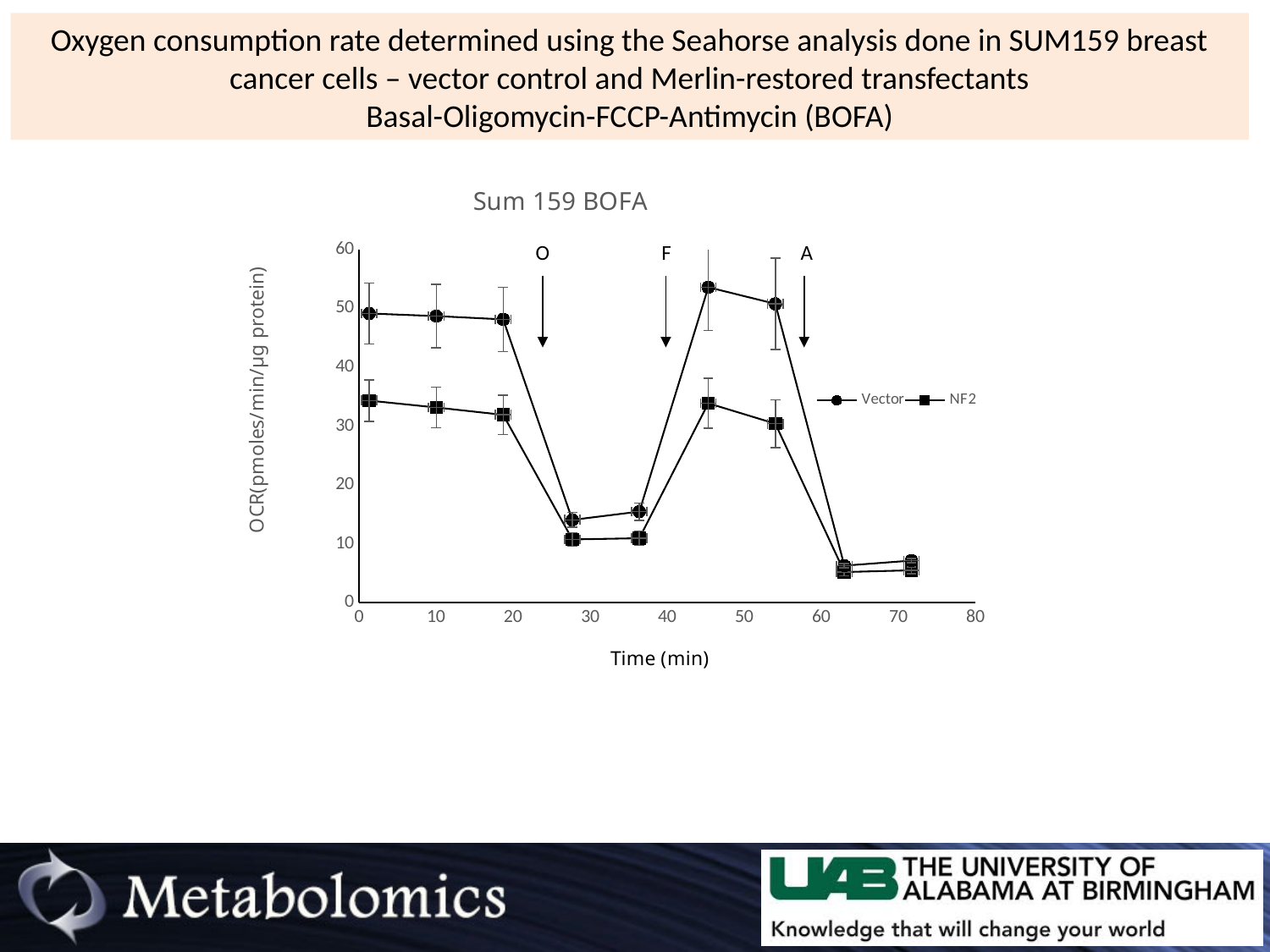
Do the NF2 values rise or fall between about 36 min and 45 min? rise Is the first Vector value (near time 0) greater or less than 40? greater What is the title of the chart? Sum 159 BOFA How many series does the legend list? 2 What kind of chart is shown on the slide? line chart Is the Vector value at around 63 min greater or less than 10? less Is the NF2 value at around 27 min greater or less than 20? less What are the two series named in the legend? Vector and NF2 At around 45 min, which series has the higher OCR, Vector or NF2? Vector Do the Vector values rise or fall between about 18 min and 27 min? fall At around 10 min, which series has the higher OCR, Vector or NF2? Vector